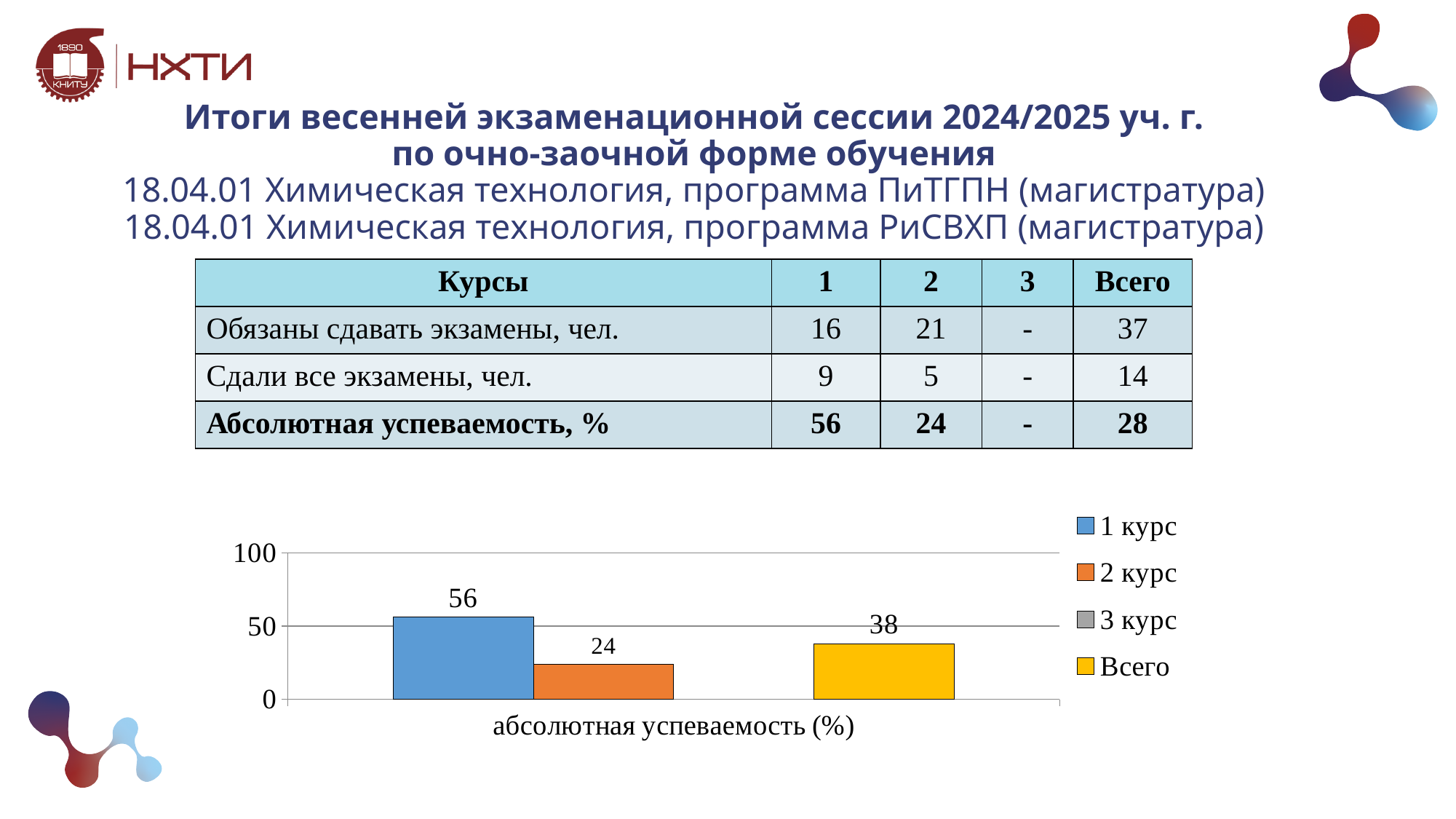
What is the value for 1 курс in the chart? 56 What is the value for 2 курс in the chart? 24 What is the value for Всего in the chart? 38 What is the difference between the values for 1 курс and 2 курс in the chart? 32 Which of the plotted bars is the lowest in the chart? 2 курс What type of chart is shown on the slide? bar chart What is the label on the x axis of the chart? абсолютная успеваемость (%) Is the value for 1 курс greater or less than 50? greater Which series has the highest bar in the chart? 1 курс Which is larger in the chart, the value for 2 курс or the value for Всего? Всего How many series does the legend list? 4 What is the difference between the values for 1 курс and Всего in the chart? 18